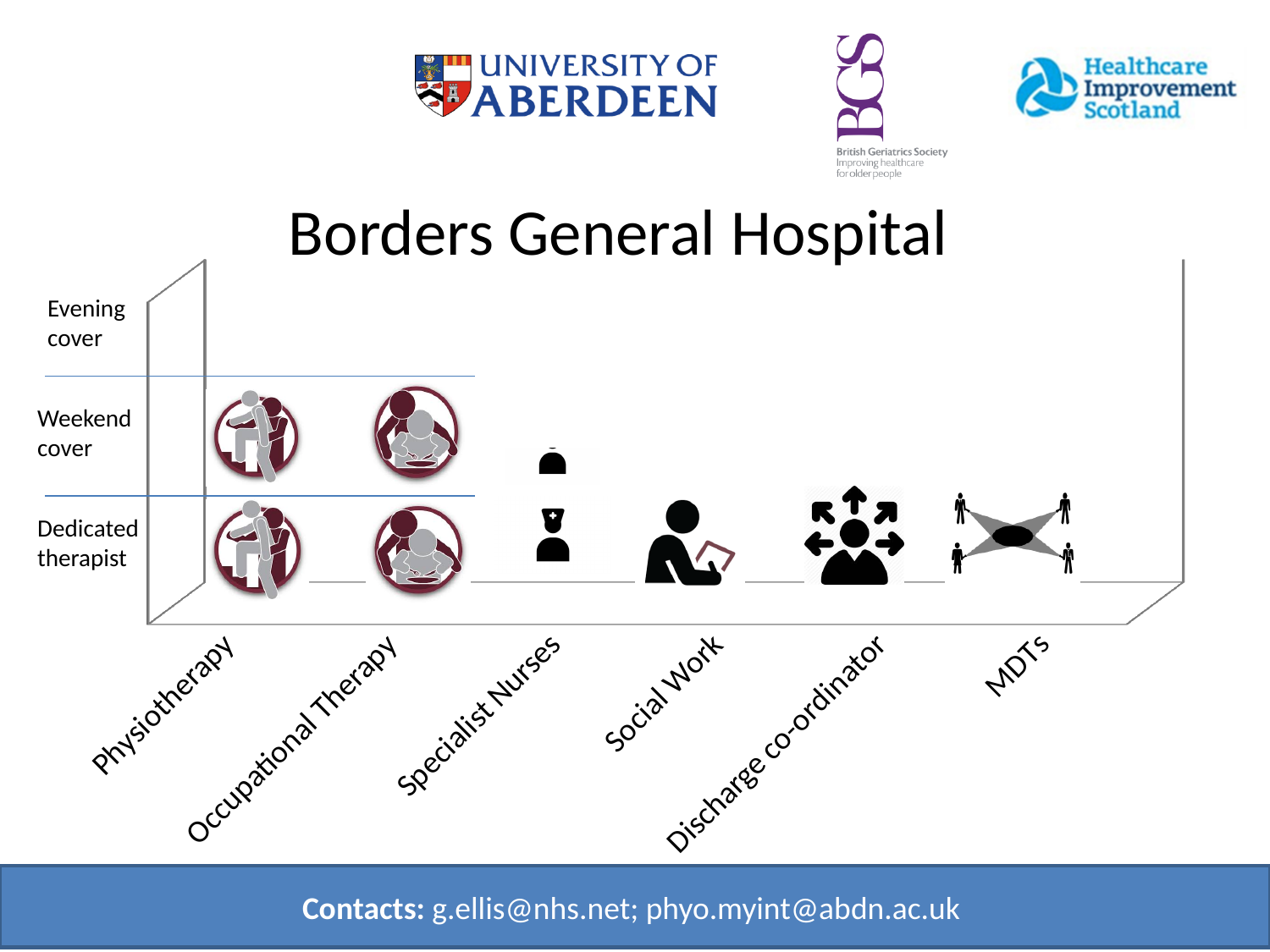
What is the title of the chart? Borders General Hospital What is the highest level reached by Social Work? Dedicated therapist What is the highest level labelled on the vertical axis? Evening cover What is the highest level reached by MDTs? Dedicated therapist Does Occupational Therapy reach the Weekend cover level? Yes Does Physiotherapy reach the Weekend cover level? Yes How many levels are labelled on the vertical axis of the chart? 3 What is the lowest level labelled on the vertical axis? Dedicated therapist How many categories are shown along the x axis of the chart? 6 Which reaches a higher level, Physiotherapy or Discharge co-ordinator? Physiotherapy What is the last category on the x axis? MDTs Does any category reach the Evening cover level? No